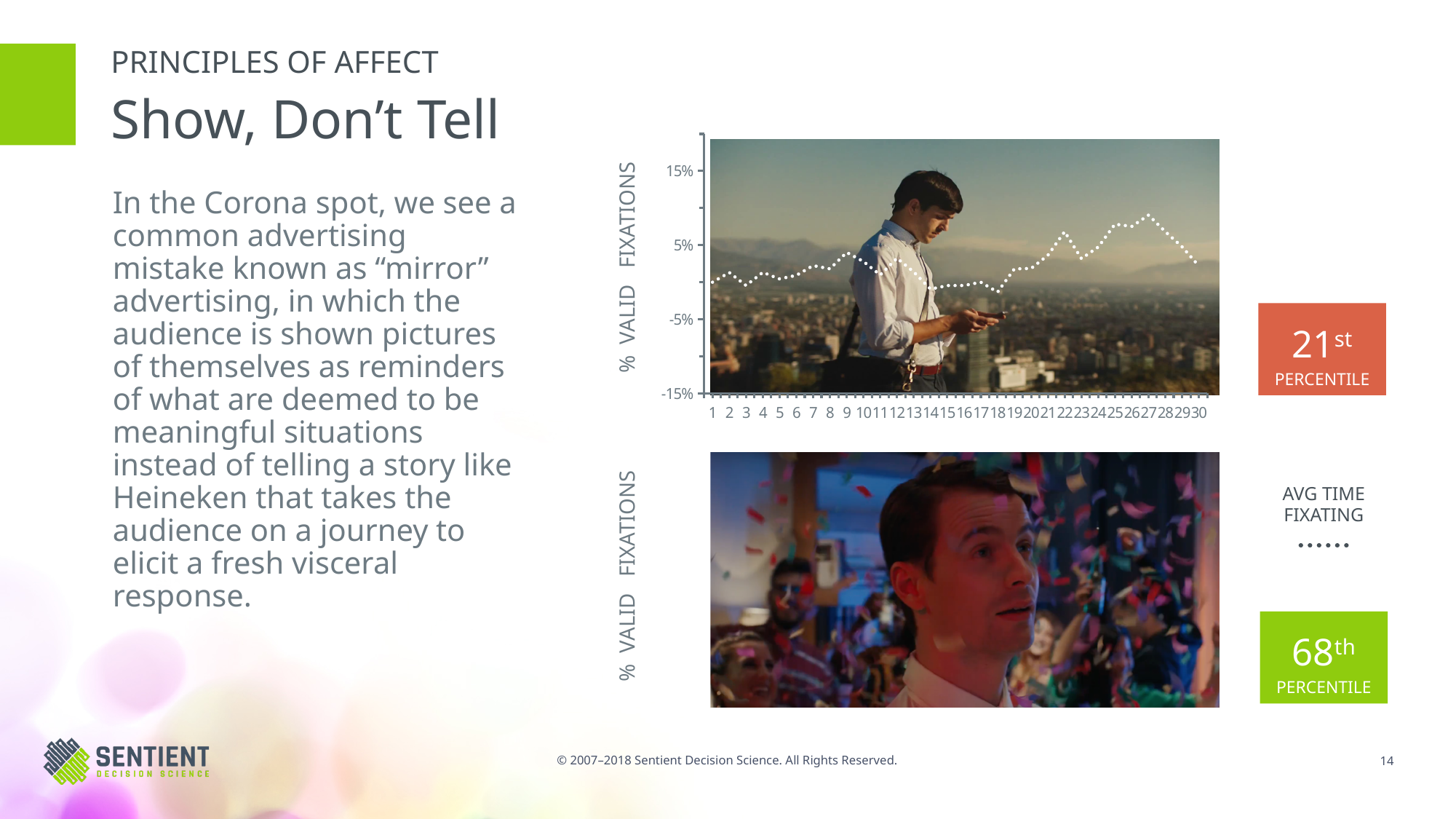
In the top chart, do the values rise or fall from point 27 to point 30? fall What is the highest tick value shown on the y axis of the top chart? 15% In the top chart, is the value at point 1 greater or less than 5%? less In the top chart, which is larger, the value at point 27 or the value at point 1? point 27 What kind of chart is shown over the top image on the slide? line chart In the top chart, do the values rise or fall from point 18 to point 27? rise In the top chart, is the value at point 22 greater or less than 5%? greater What is the label on the y axis of the top chart? % VALID FIXATIONS In the top chart, is the value at point 27 greater or less than 5%? greater How many points are labelled along the x axis of the top chart? 30